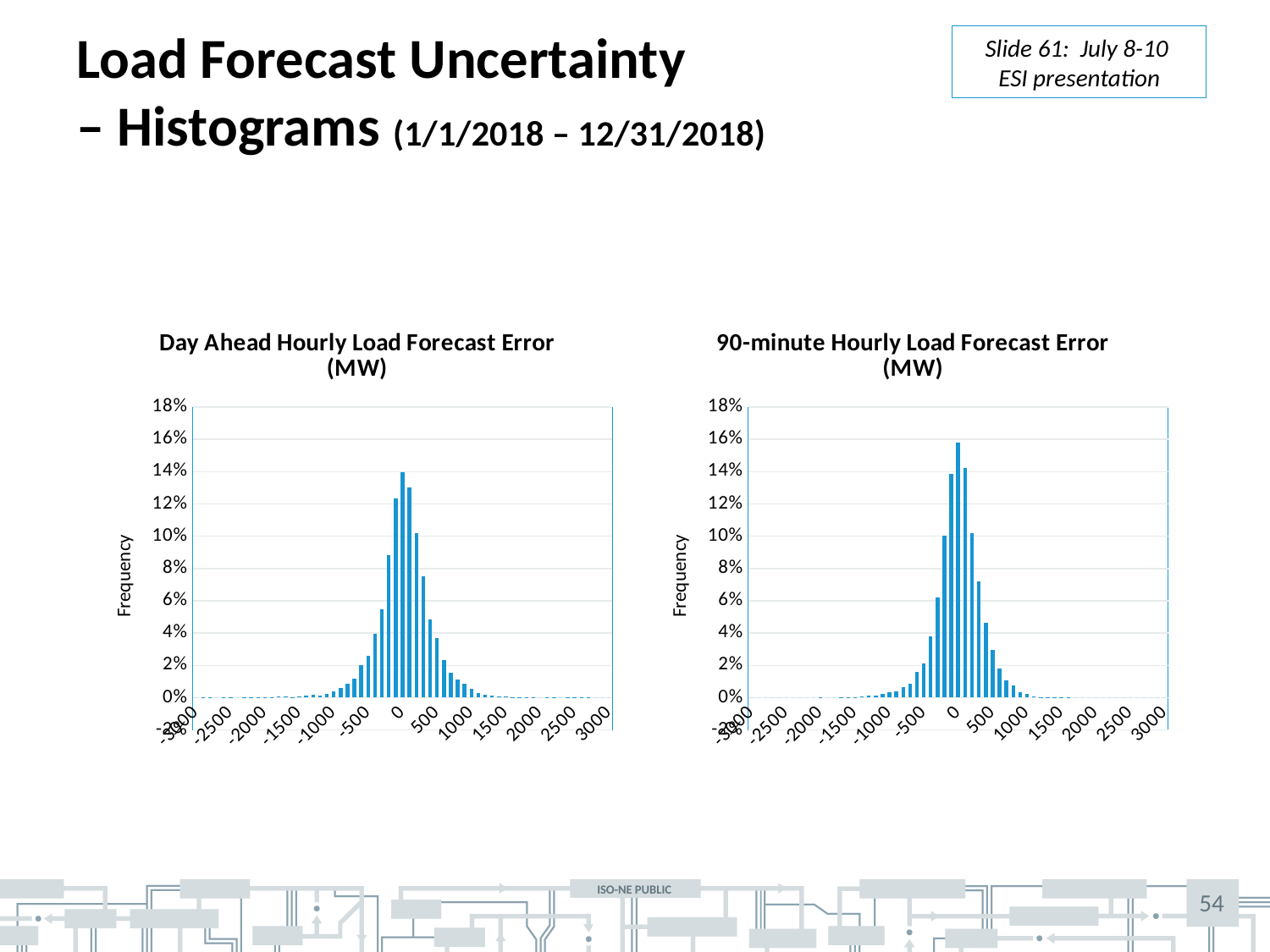
What kind of chart is the '90-minute Hourly Load Forecast Error (MW)' chart? bar chart In the '90-minute Hourly Load Forecast Error (MW)' chart, is the tallest bar greater or less than 18%? less What kind of chart is the 'Day Ahead Hourly Load Forecast Error (MW)' chart? bar chart Which chart has the taller peak bar, 'Day Ahead Hourly Load Forecast Error (MW)' or '90-minute Hourly Load Forecast Error (MW)'? 90-minute Hourly Load Forecast Error (MW) In the 'Day Ahead Hourly Load Forecast Error (MW)' chart, is the tallest bar greater or less than 16%? less In the '90-minute Hourly Load Forecast Error (MW)' chart, is the tallest bar greater or less than 14%? greater In the 'Day Ahead Hourly Load Forecast Error (MW)' chart, do the bar heights rise or fall as the x-axis moves from 500 to 1500? fall What is the y-axis label on the '90-minute Hourly Load Forecast Error (MW)' chart? Frequency What is the title of the chart on the left side of the slide? Day Ahead Hourly Load Forecast Error (MW)